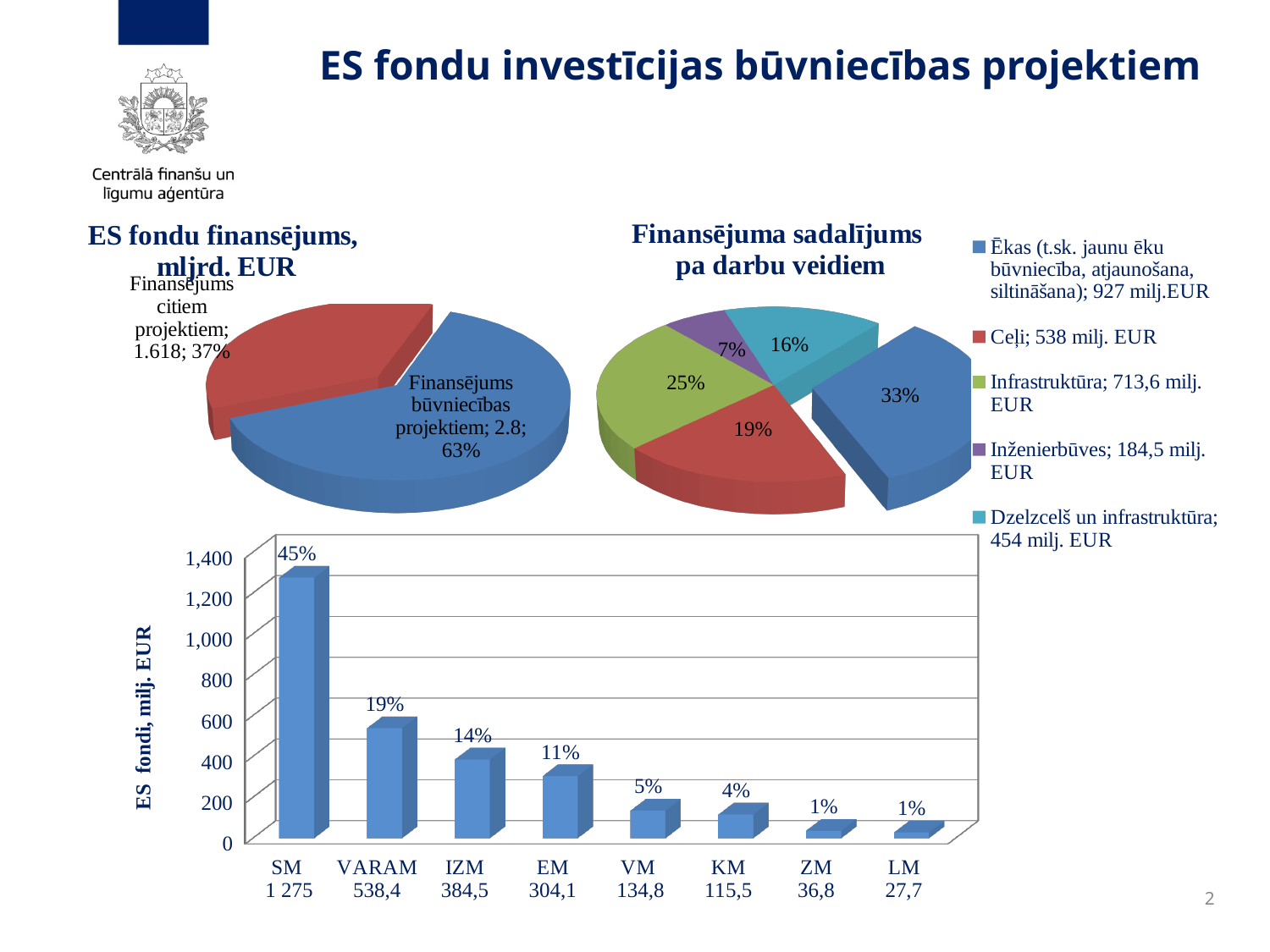
In the right pie chart 'Finansējuma sadalījums pa darbu veidiem', what value does the legend give for 'Ceļi'? 538 milj. EUR In the bottom bar chart, which ministry has the highest value? SM In the left pie chart 'ES fondu finansējums, mljrd. EUR', what share does 'Finansējums būvniecības projektiem' have? 63% In the bottom bar chart, how many ministries (categories) are shown? 8 In the bottom bar chart, is the value for VM greater or less than 200? less In the bottom bar chart, which ministry has the lowest value? LM What kind of chart is the bottom chart showing SM, VARAM, IZM and other ministries? bar chart In the bottom bar chart, do the values rise or fall from left to right along the x axis? fall In the right pie chart 'Finansējuma sadalījums pa darbu veidiem', how many entries does the legend list? 5 In the bottom bar chart, what percentage is labelled above the VARAM bar? 19% In the bottom bar chart, which is larger, the value for IZM or the value for EM? IZM In the bottom bar chart, what is the difference between the SM value (1 275) and the VARAM value (538,4)? 736,6